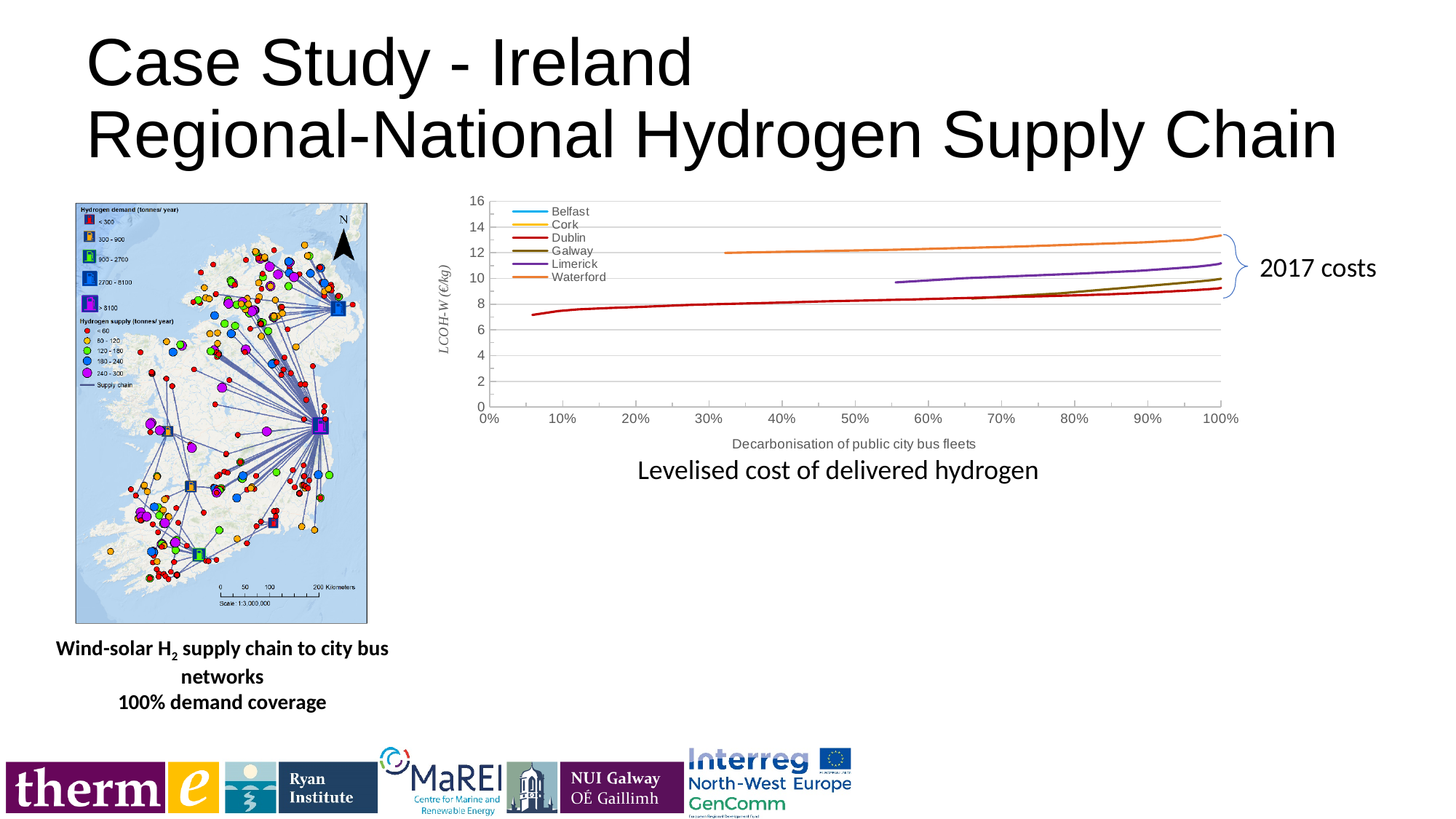
In the 'Levelised cost of delivered hydrogen' chart, which is larger at 100% decarbonisation: the value for Waterford or the value for Limerick? Waterford What is the x-axis label of the 'Levelised cost of delivered hydrogen' chart? Decarbonisation of public city bus fleets In the 'Levelised cost of delivered hydrogen' chart, do the plotted lines rise or fall as decarbonisation increases? rise How many series does the legend of the 'Levelised cost of delivered hydrogen' chart list? 6 In the 'Levelised cost of delivered hydrogen' chart, which city has the highest levelised cost across the plotted range? Waterford In the 'Levelised cost of delivered hydrogen' chart, is the value for Dublin at 100% decarbonisation greater or less than 10? less What is the y-axis label of the 'Levelised cost of delivered hydrogen' chart? LCOH-W (€/kg) In the 'Levelised cost of delivered hydrogen' chart, is the value for Limerick at 100% decarbonisation greater or less than 10? greater In the 'Levelised cost of delivered hydrogen' chart, is the value for Waterford at 100% decarbonisation greater or less than 12? greater What kind of chart is the 'Levelised cost of delivered hydrogen' chart? line chart